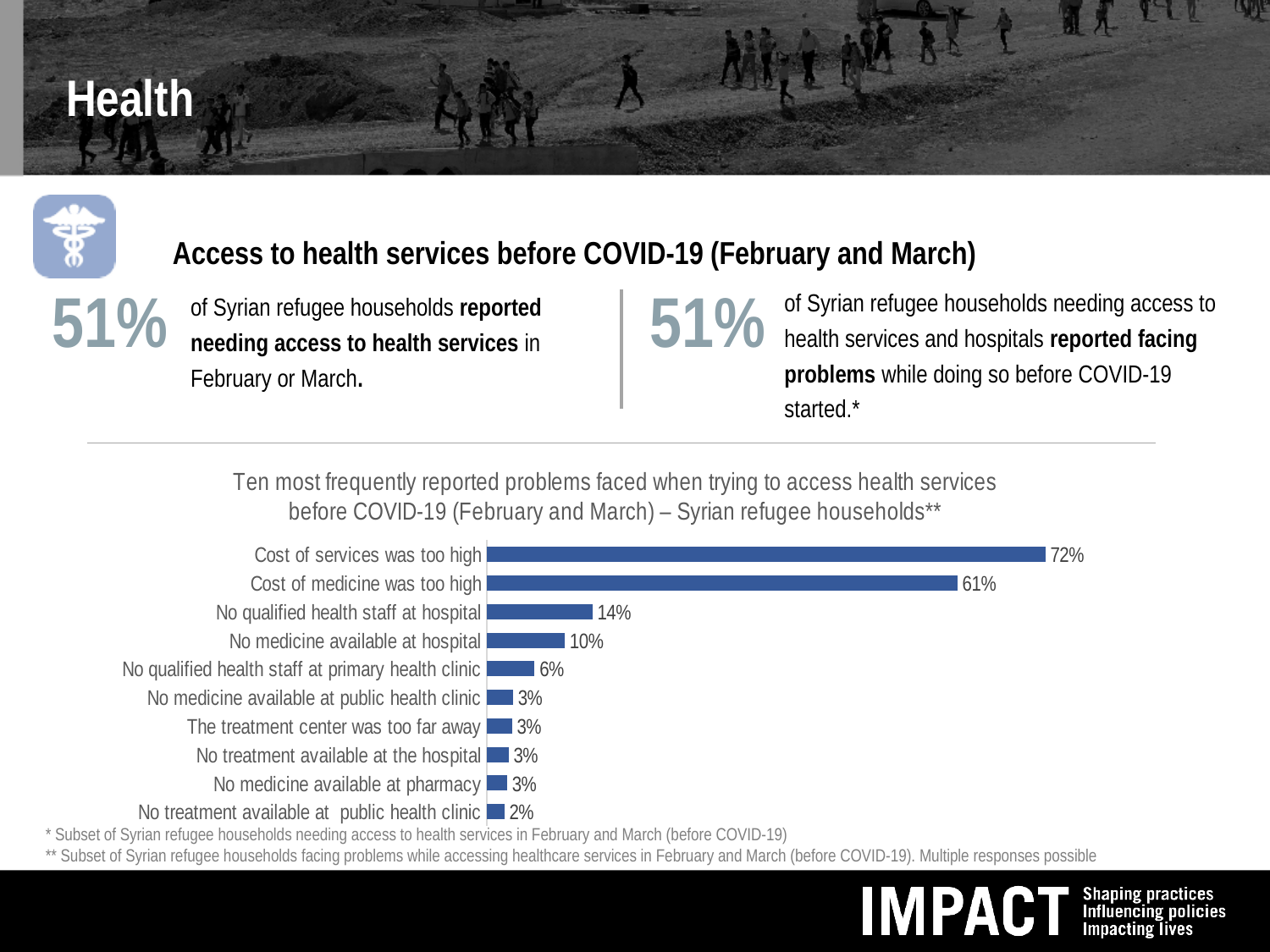
What is the title of the chart? Ten most frequently reported problems faced when trying to access health services before COVID-19 (February and March) – Syrian refugee households** What is the value for 'No treatment available at public health clinic'? 2% How many problems are listed in the chart? 10 Which problem has the lowest reported percentage? No treatment available at public health clinic Which is larger: 'No medicine available at hospital' or 'No qualified health staff at primary health clinic'? No medicine available at hospital What percentage reported no qualified health staff at hospital? 14% What is the value for 'Cost of medicine was too high'? 61% Which problem was reported most frequently? Cost of services was too high What percentage of Syrian refugee households reported that the cost of services was too high? 72% What is the difference between 'Cost of services was too high' and 'Cost of medicine was too high'? 11 percentage points What is the difference between 'No qualified health staff at hospital' and 'No medicine available at hospital'? 4 percentage points What type of chart is used to show the reported problems? Bar chart